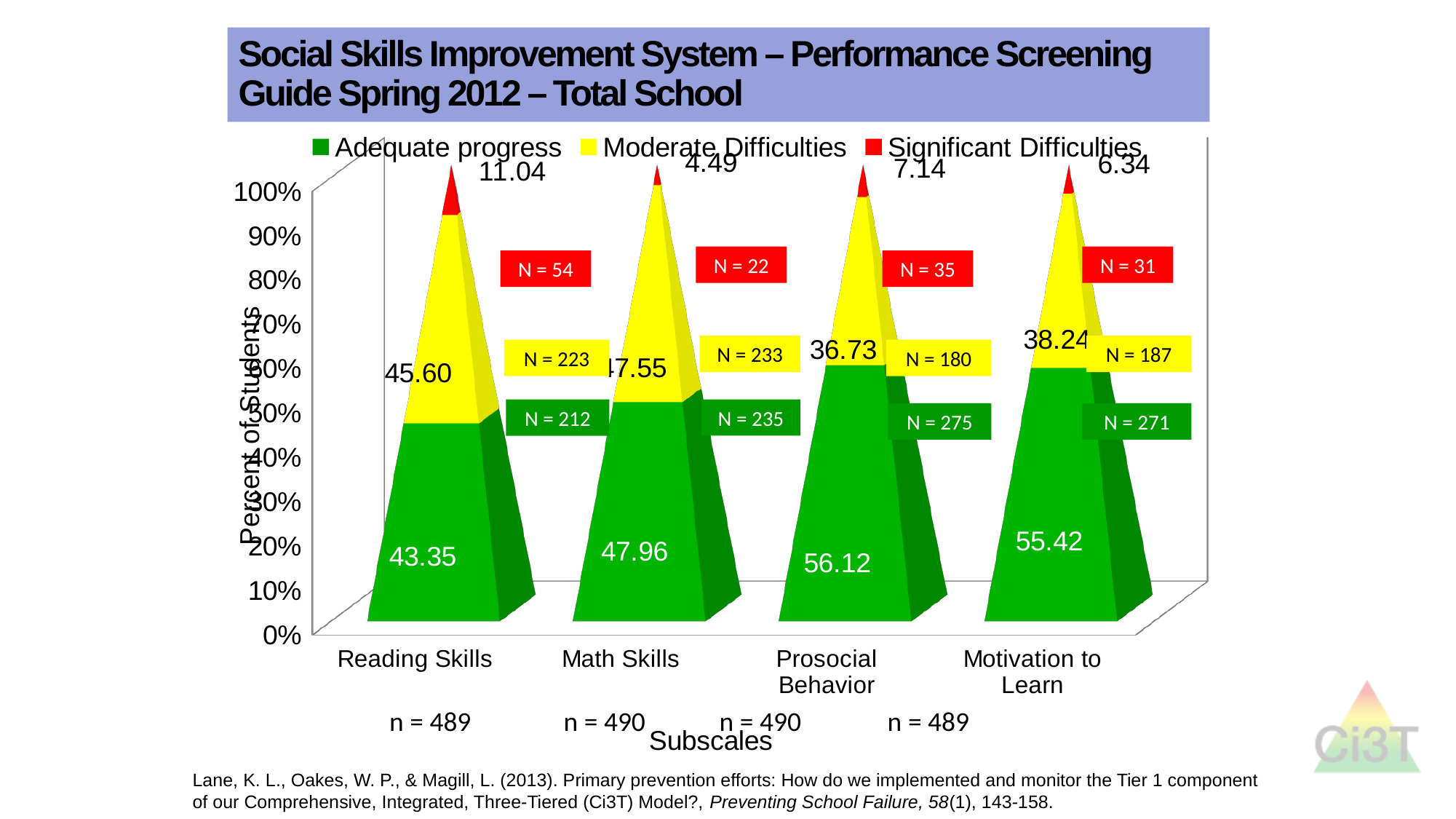
What is the Adequate progress value for Motivation to Learn? 55.42 What is the difference between the Adequate progress values for Prosocial Behavior and Reading Skills? 12.77 What is the Significant Difficulties value for Math Skills? 4.49 What is the Significant Difficulties value for Reading Skills? 11.04 Which subscale has the lowest Significant Difficulties value? Math Skills What is the Moderate Difficulties value for Prosocial Behavior? 36.73 Which has a larger Adequate progress value, Math Skills or Reading Skills? Math Skills How many subscales are shown on the x axis? 4 How many series does the legend list? 3 What is the Adequate progress value for Reading Skills? 43.35 Which subscale has the highest Adequate progress value? Prosocial Behavior Which subscale has the highest Significant Difficulties value? Reading Skills